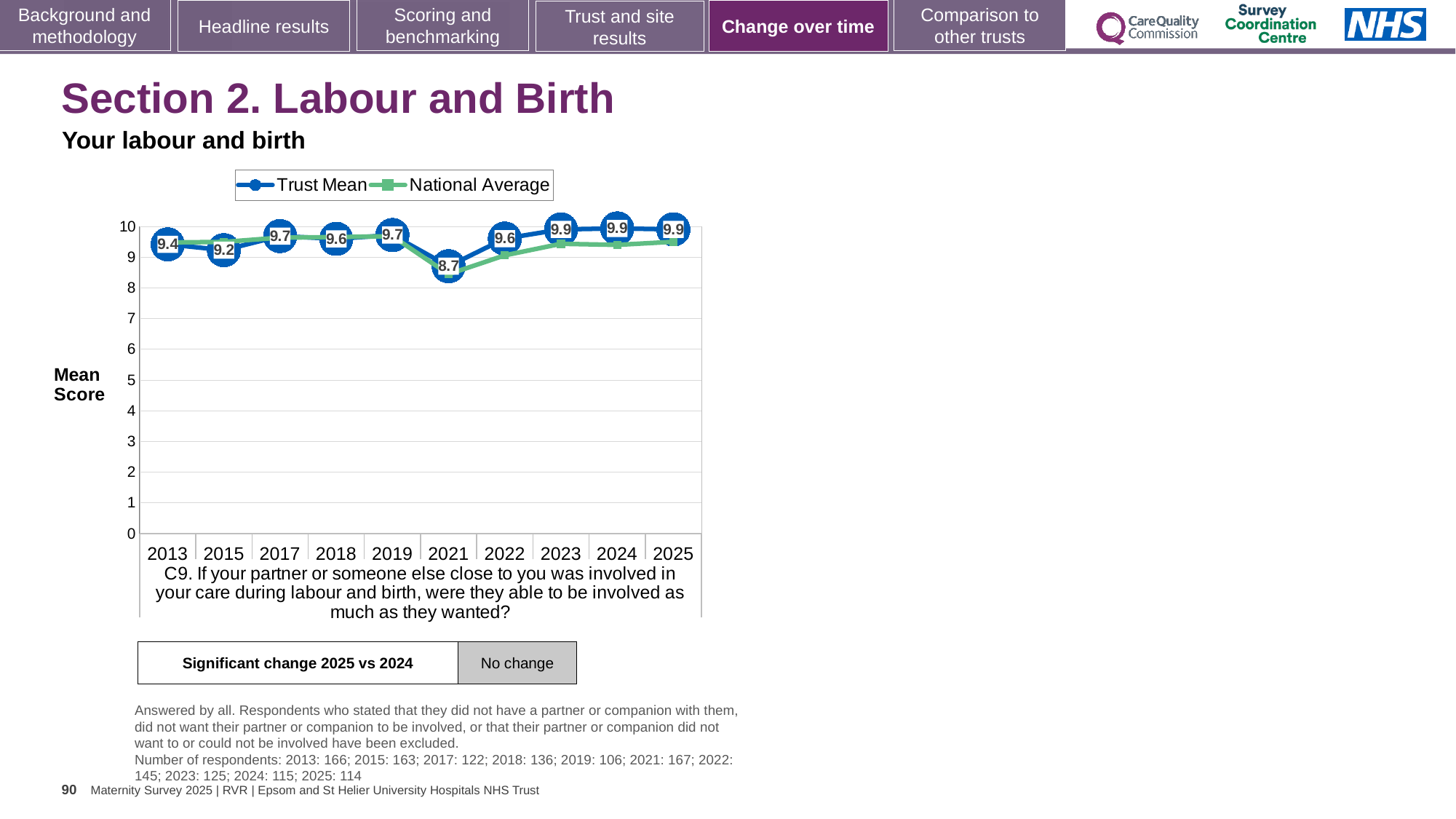
How many survey years are shown on the x axis? 10 What is the Trust Mean score for 2025? 9.9 What is the difference between the Trust Mean score in 2025 and in 2021? 1.2 What are the two series named in the legend? Trust Mean and National Average Which year has the higher Trust Mean score, 2015 or 2017? 2017 What is the Trust Mean score for 2021? 8.7 Does the Trust Mean score rise or fall from 2021 to 2023? rise What kind of chart is shown on the slide? line chart What is the Trust Mean score for 2013? 9.4 How many series does the legend list? 2 In which year is the Trust Mean score lowest? 2021 Is the National Average value for 2021 greater or less than 9? less